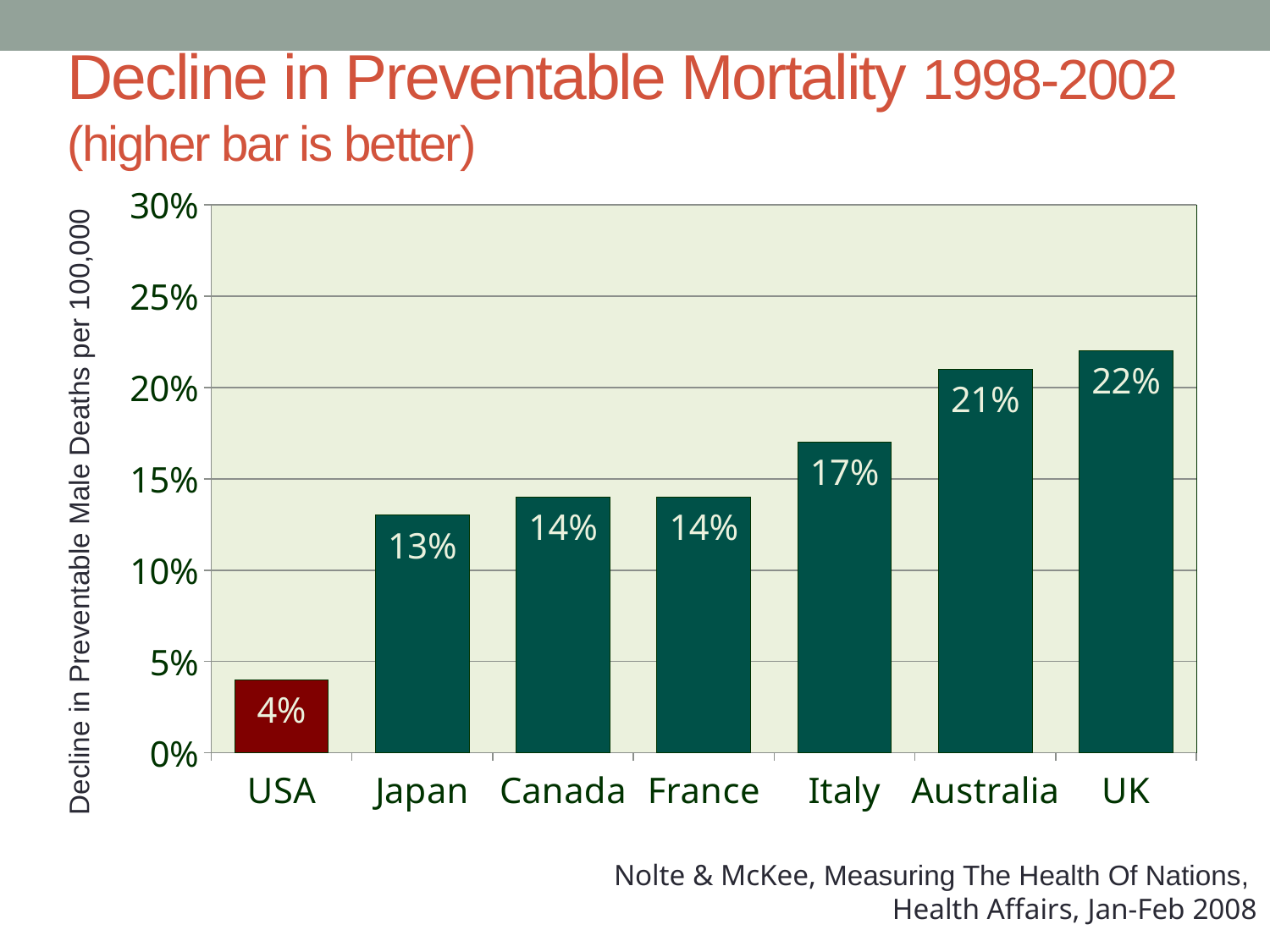
What is the difference between the UK's and the USA's decline in preventable mortality? 18% What is the label of the vertical axis? Decline in Preventable Male Deaths per 100,000 Which country has the highest decline in preventable mortality? UK What kind of chart is shown on the slide? Bar chart Which has a larger decline in preventable mortality, Italy or Japan? Italy What is the decline in preventable mortality for the USA? 4% What is the decline in preventable mortality for Australia? 21% Is the value for Italy greater or less than 15%? greater How many countries are shown in the chart? 7 Which country has the lowest decline in preventable mortality? USA What is the decline in preventable mortality for Italy? 17% What is the difference between Australia's and Japan's decline in preventable mortality? 8%